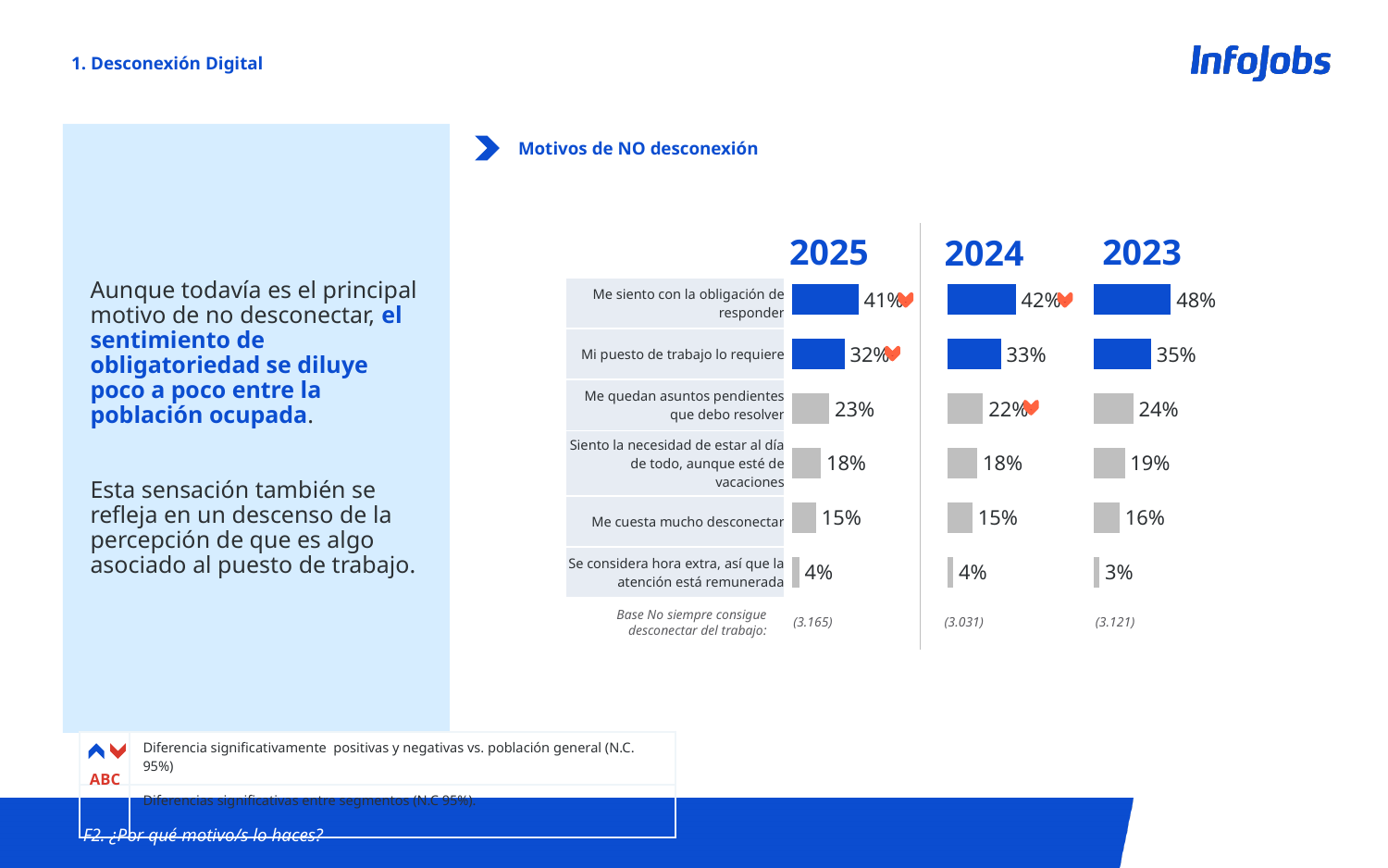
In the 2024 chart, what is the difference between "Mi puesto de trabajo lo requiere" and "Me quedan asuntos pendientes que debo resolver"? 11 percentage points In the 2025 chart, which category has the highest value? Me siento con la obligación de responder In the 2025 chart, what is the value for "Me siento con la obligación de responder"? 41% What is the difference between the 2023 and 2025 values for "Me siento con la obligación de responder"? 7 percentage points Which years are shown as column headings above the bar charts? 2025, 2024, 2023 What kind of chart is used to show the "Motivos de NO desconexión" data? Bar chart In the 2023 chart, what is the value for "Mi puesto de trabajo lo requiere"? 35% How many categories are shown in each of the bar charts? 6 In the 2023 chart, which category has the lowest value? Se considera hora extra, así que la atención está remunerada Is the value for "Me cuesta mucho desconectar" larger in the 2023 chart or the 2024 chart? 2023 What is the base (number of respondents) shown for the 2025 chart? 3.165 In the 2024 chart, what is the value for "Me quedan asuntos pendientes que debo resolver"? 22%